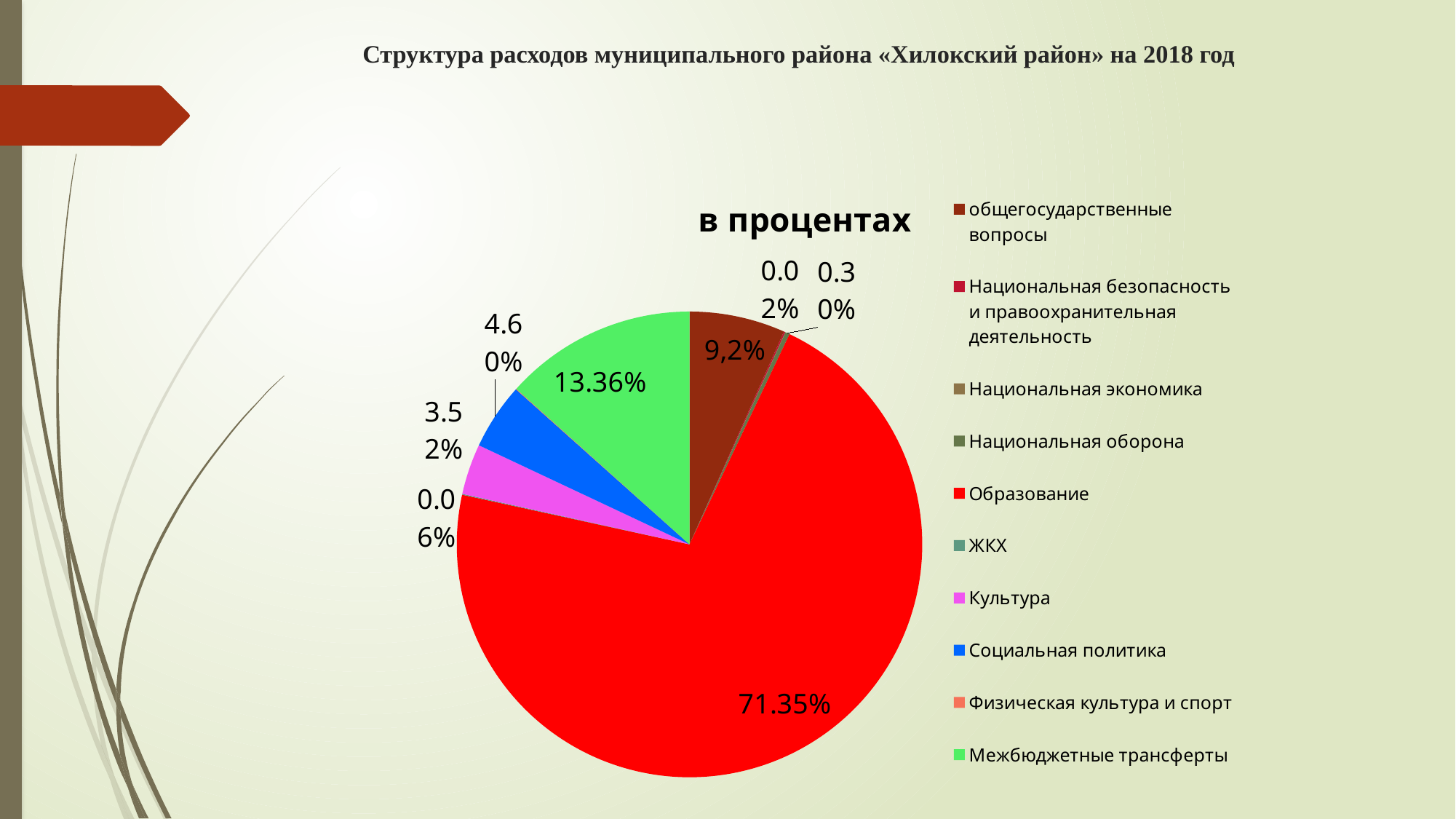
What is the chart's title? в процентах What is the difference between the shares of Образование and Межбюджетные трансферты? 57.99% What share of the pie does общегосударственные вопросы take? 9,2% What share of the pie does Культура take? 3.52% How many entries does the legend list? 10 What colour is the Образование slice? red Which slice is larger: Межбюджетные трансферты or общегосударственные вопросы? Межбюджетные трансферты What share of the pie does Межбюджетные трансферты take? 13.36% What kind of chart is shown on the slide? pie chart Which category has the largest slice of the pie? Образование What share of the pie does Образование take? 71.35% What share of the pie does Социальная политика take? 4.60%